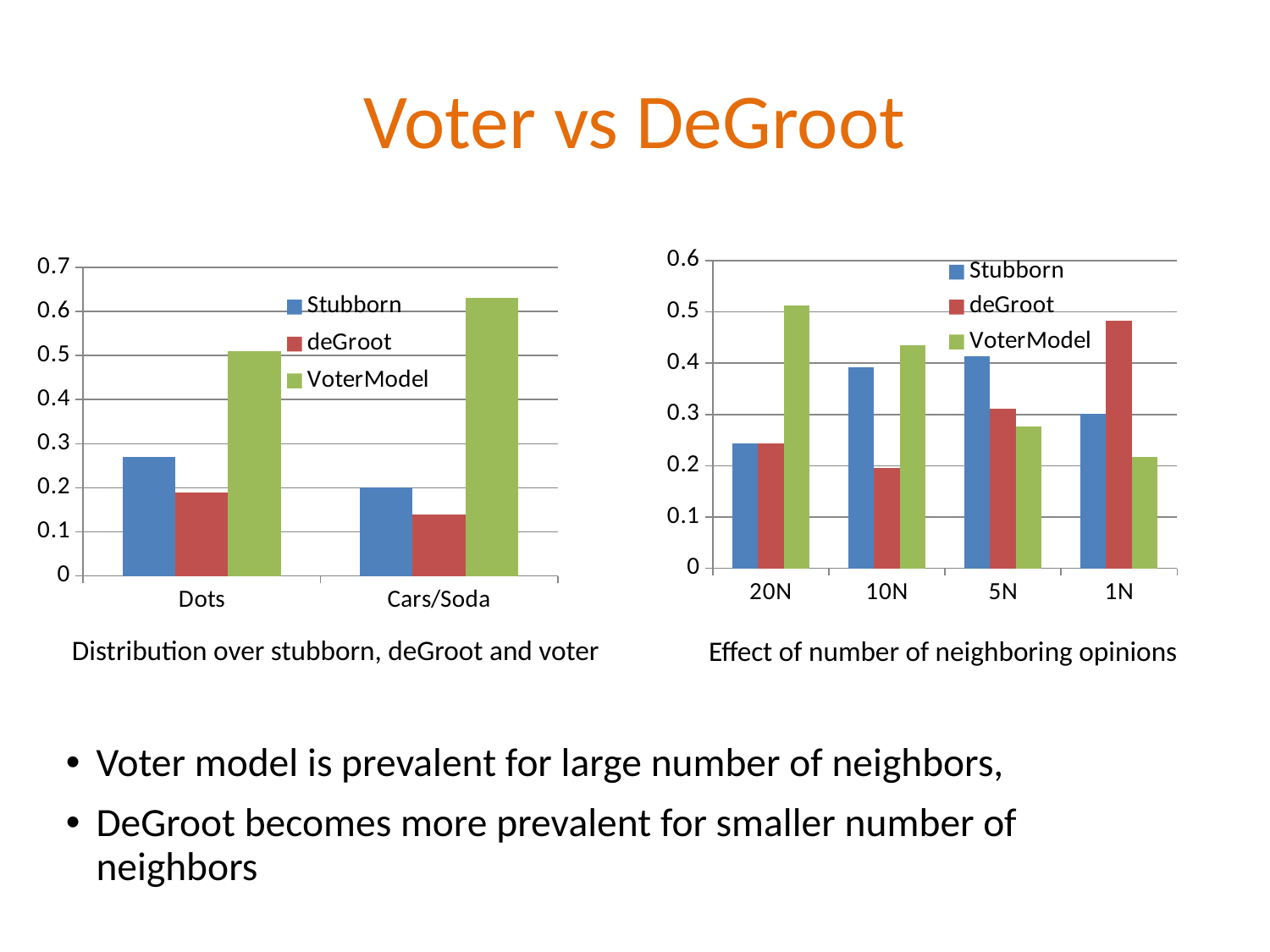
How many series does the legend of the right chart, 'Effect of number of neighboring opinions', list? 3 In the left chart, is the VoterModel value for Cars/Soda greater or less than 0.6? greater In the left chart, which series has the highest value for Cars/Soda? VoterModel How many categories are shown on the x axis of the left chart, 'Distribution over stubborn, deGroot and voter'? 2 In the right chart, does the VoterModel series rise or fall from 20N to 1N? fall In the right chart, which series has the highest value for 1N? deGroot In the left chart, which series has the lowest value for Dots? deGroot How many categories are shown on the x axis of the right chart, 'Effect of number of neighboring opinions'? 4 What kind of chart is the left chart, 'Distribution over stubborn, deGroot and voter'? bar chart In the right chart, is the VoterModel value for 20N greater or less than 0.5? greater In the right chart, which is larger for 10N: Stubborn or deGroot? Stubborn